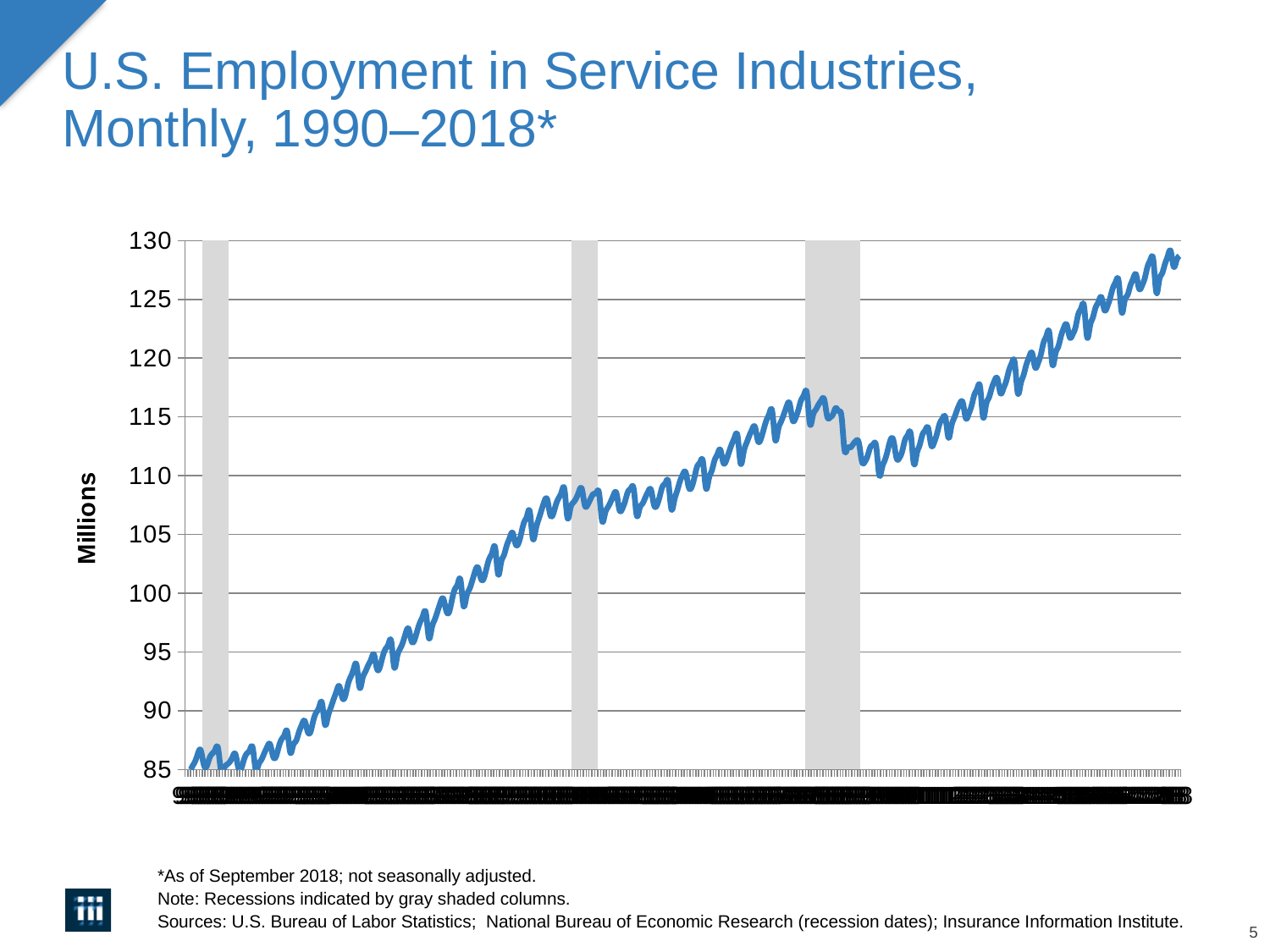
What is the lowest tick value shown on the vertical axis? 85 Is the value at the start of the series in 1990 greater or less than 90? less What is the label on the vertical axis of the chart? Millions Is the value at the end of the series (September 2018) greater or less than 130? less Overall, do the values rise or fall from 1990 to 2018 along the x axis? rise How many gray shaded recession columns are shown on the chart? 3 Which is larger, the value at the start of the series in 1990 or the value at the end in September 2018? September 2018 What kind of chart is shown on the slide? line chart Is the value at the end of the series (September 2018) greater or less than 125? greater What is the highest tick value shown on the vertical axis? 130